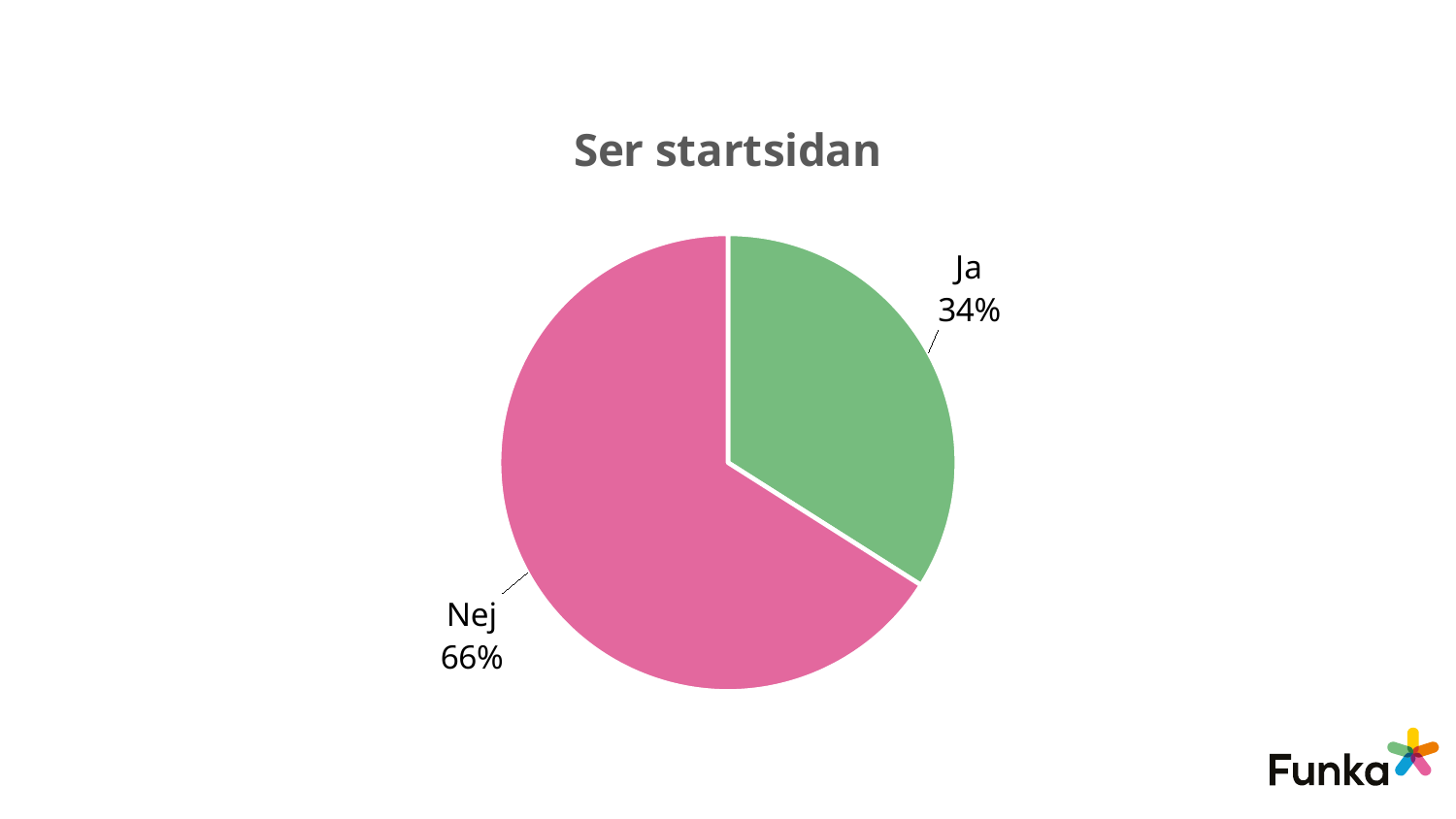
What share of the pie does the "Ja" slice represent? 34% Which slice is the smallest in the pie chart? Ja Which slice is the largest in the pie chart? Nej Is the value for "Ja" greater or less than 50%? less What share of the pie does the "Nej" slice represent? 66% What colour is the "Nej" slice? pink How many slices does the pie chart have? 2 What kind of chart is shown on the slide? pie chart What is the difference in percentage points between the "Nej" and "Ja" slices? 32 Which is larger, the "Ja" slice or the "Nej" slice? Nej What is the title of the chart? Ser startsidan